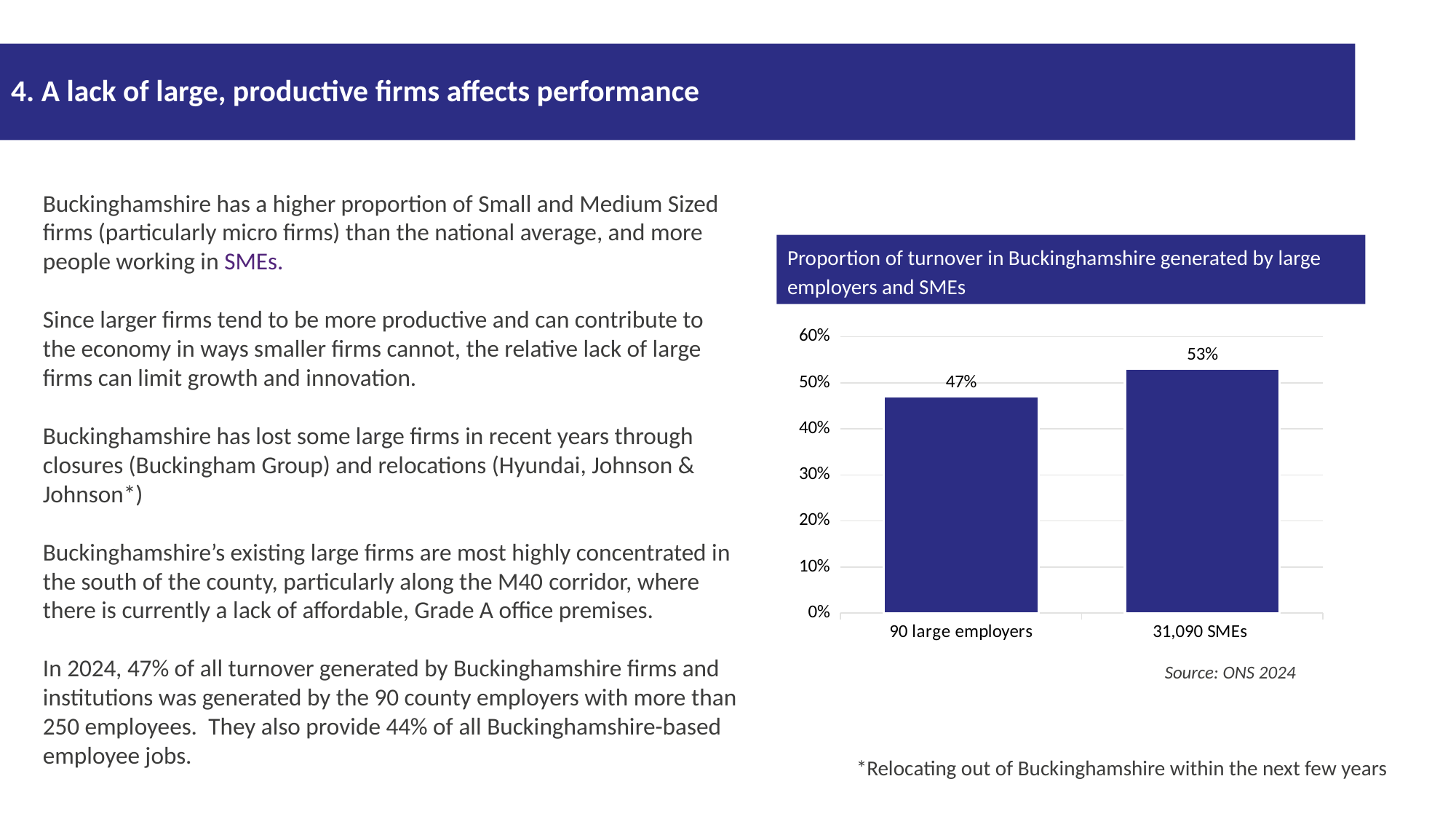
Is the value for 90 large employers greater or less than 50%? less Is the value for 31,090 SMEs greater or less than 50%? greater How many categories are shown on the chart? 2 Which category generates the lower proportion of turnover? 90 large employers What proportion of turnover is generated by the 90 large employers? 47% What is the source cited for the chart? ONS 2024 What proportion of turnover is generated by the 31,090 SMEs? 53% What is the highest value shown on the chart's vertical axis? 60% What is the difference in percentage points between the SMEs' share and the large employers' share of turnover? 6 percentage points What kind of chart is shown on the slide? Bar chart Which category generates the higher proportion of turnover? 31,090 SMEs What is the title of the chart? Proportion of turnover in Buckinghamshire generated by large employers and SMEs